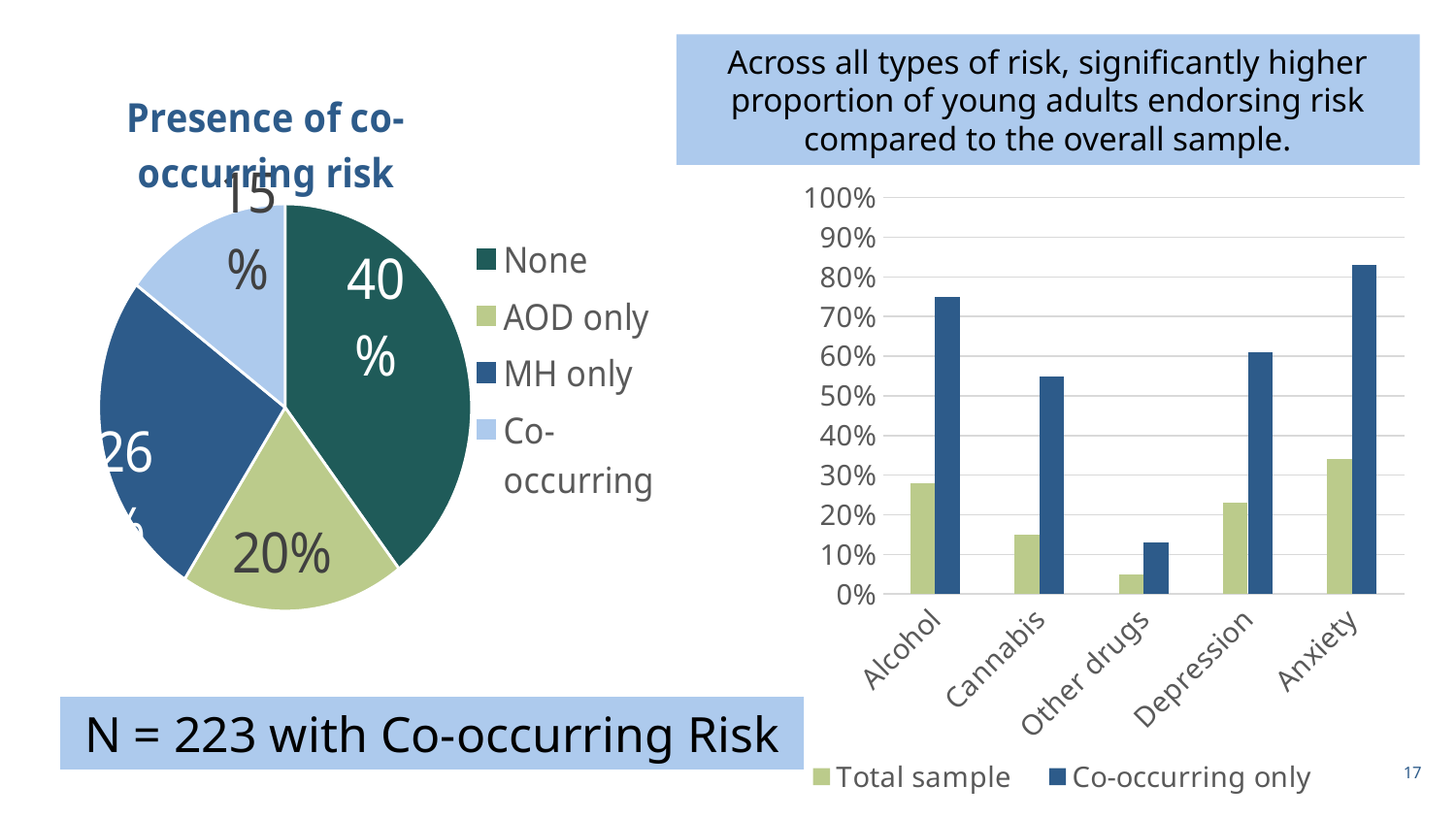
What kind of chart is the one on the right side of the slide? Bar chart In the pie chart titled 'Presence of co-occurring risk', what percentage is shown for the 'AOD only' slice? 20% In the bar chart on the right, is the 'Co-occurring only' value for Alcohol greater or less than 70%? greater How many series does the legend of the bar chart on the right list? 2 In the pie chart titled 'Presence of co-occurring risk', what percentage is shown for the 'None' slice? 40% In the bar chart on the right, is the 'Total sample' value for Other drugs greater or less than 10%? less In the pie chart titled 'Presence of co-occurring risk', what percentage is shown for the 'Co-occurring' slice? 15% How many categories does the pie chart titled 'Presence of co-occurring risk' show? 4 In the pie chart titled 'Presence of co-occurring risk', how many percentage points larger is the 'None' slice than the 'AOD only' slice? 20 percentage points In the pie chart titled 'Presence of co-occurring risk', which category has the largest slice? None In the pie chart titled 'Presence of co-occurring risk', which category has the smallest slice? Co-occurring In the bar chart on the right, which category has the highest 'Co-occurring only' value? Anxiety